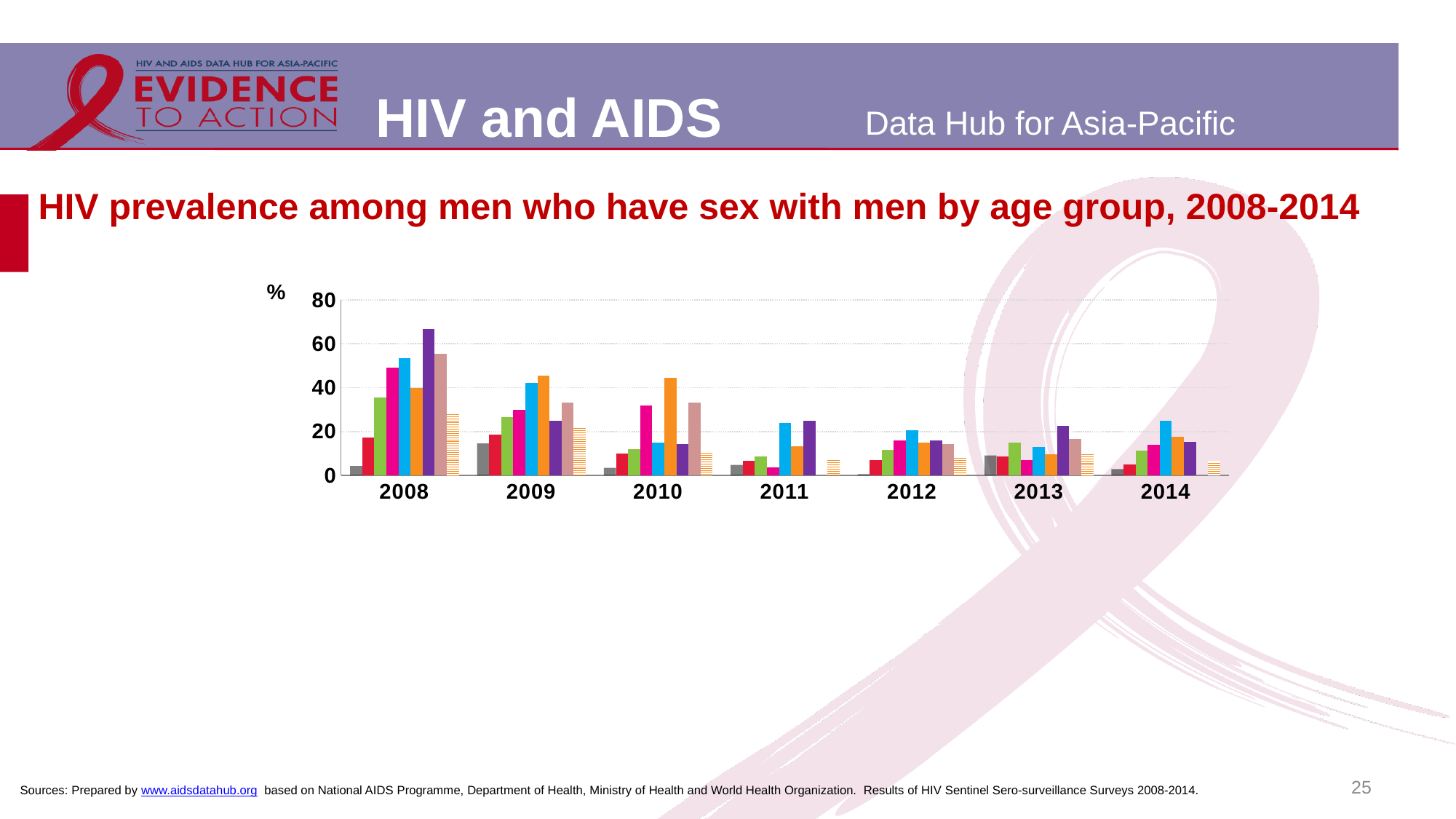
Is the value of the light blue bar for 2008 greater or less than 40? greater What is the title of the chart on the slide? HIV prevalence among men who have sex with men by age group, 2008-2014 What kind of chart is shown on the slide? bar chart Is the value of the orange bar for 2010 greater or less than 40? greater Is the value of the purple bar for 2008 greater or less than 60? greater What unit is shown on the y axis of the chart? % Which is larger, the purple bar for 2008 or the purple bar for 2014? the purple bar for 2008 Which year contains the tallest bar in the chart? 2008 How many years are shown along the x axis of the chart? 7